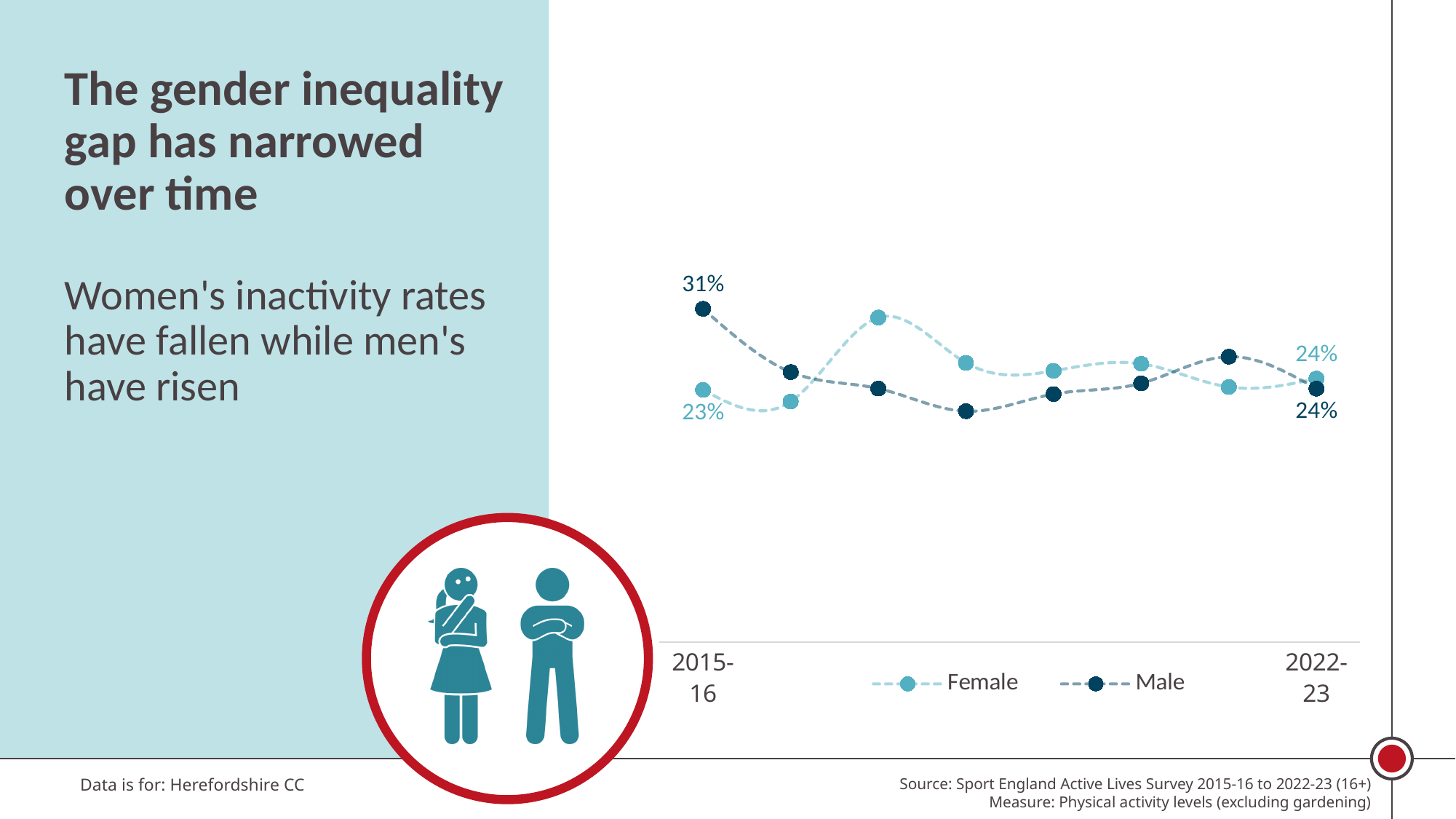
What was the Female inactivity rate in 2015-16? 23% By how much did the Male inactivity rate fall between 2015-16 and 2022-23? 7 percentage points In 2015-16, which series had the higher inactivity rate, Female or Male? Male How many time points are plotted for each series? 8 Did the Male inactivity rate rise or fall overall from 2015-16 to 2022-23? Fall What was the Female inactivity rate in 2022-23? 24% Which series is shown with the darker line and markers? Male What kind of chart is shown on the slide? Line chart What is the difference between the Male and Female inactivity rates in 2015-16? 8 percentage points What was the Male inactivity rate in 2015-16? 31% What was the Male inactivity rate in 2022-23? 24% How many series does the legend list? 2